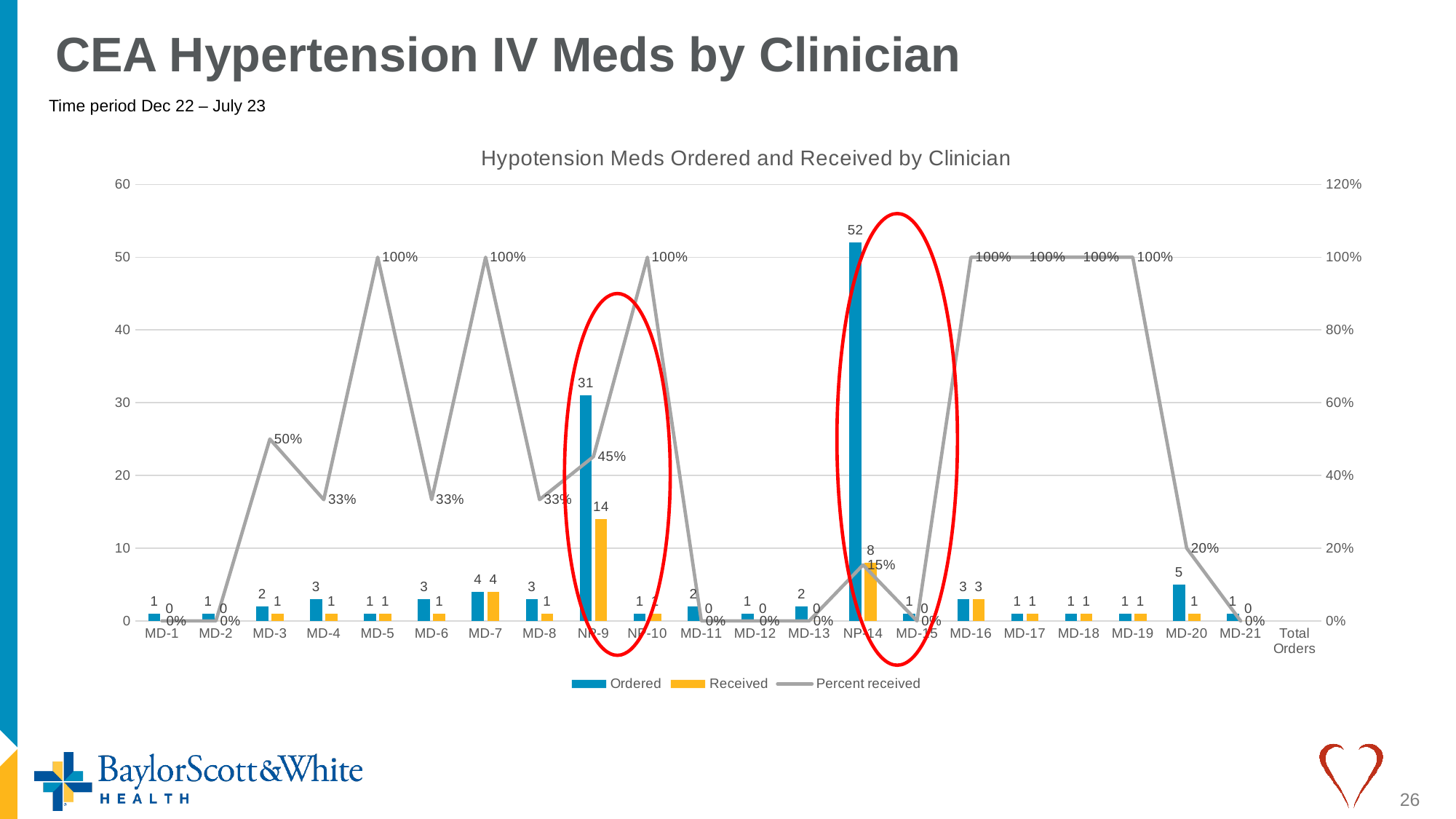
How many IV meds were ordered by NP-14? 52 Which clinician received more meds, MD-7 or MD-20? MD-7 How many series does the legend list? 3 What is the percent received for MD-20? 20% How many meds were received for NP-9? 14 Is the number of meds ordered by NP-9 greater or less than 30? greater What is the difference between the number ordered by NP-14 and the number ordered by NP-9? 21 For NP-14, what is the difference between meds ordered and meds received? 44 What is the title of the chart? Hypotension Meds Ordered and Received by Clinician How many meds were ordered by MD-20? 5 What is the percent received for MD-3? 50% Which clinician has the highest number of meds ordered? NP-14